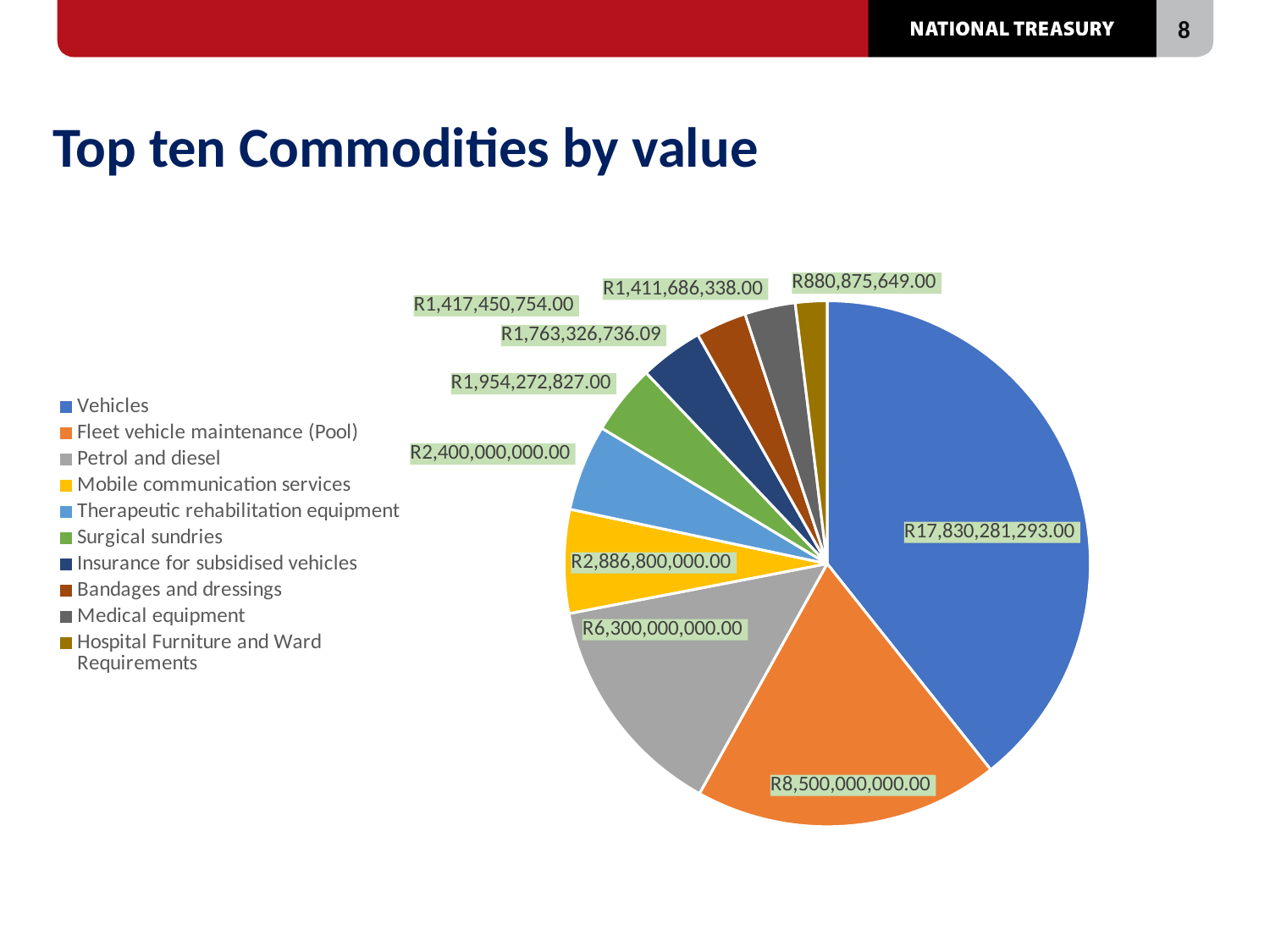
Which commodity has the largest value? Vehicles How many commodities are shown in the pie chart? 10 What is the value for Mobile communication services? R2,886,800,000.00 What is the value for Vehicles? R17,830,281,293.00 What is the difference between the values for Vehicles and Fleet vehicle maintenance (Pool)? R9,330,281,293.00 What is the value for Petrol and diesel? R6,300,000,000.00 What type of chart is shown on the slide? Pie chart What is the value for Fleet vehicle maintenance (Pool)? R8,500,000,000.00 Which commodity has the smallest value? Hospital Furniture and Ward Requirements What is the value for Insurance for subsidised vehicles? R1,763,326,736.09 What is the title of the slide containing the chart? Top ten Commodities by value Which is larger, the value for Petrol and diesel or the value for Mobile communication services? Petrol and diesel